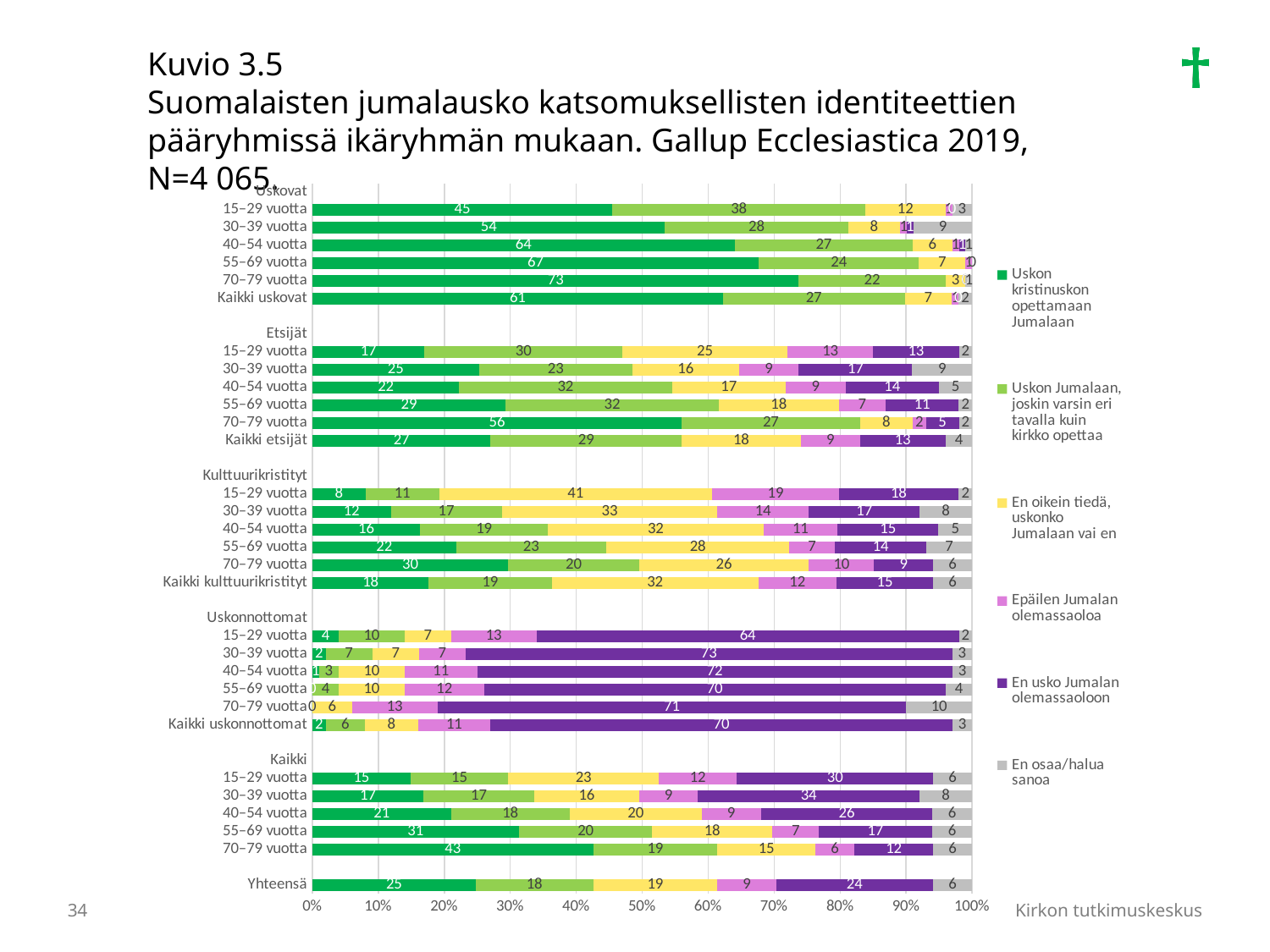
In the Uskonnottomat group, what is the value for 'En usko Jumalan olemassaoloon' for 15–29 vuotta? 64 Among the Kulttuurikristityt age groups, which has the lowest value for 'Uskon kristinuskon opettamaan Jumalaan'? 15–29 vuotta In the Uskovat group, what is the value for 'Uskon kristinuskon opettamaan Jumalaan' for 70–79 vuotta? 73 In the Kaikki uskonnottomat bar, what is the value for 'En usko Jumalan olemassaoloon'? 70 What kind of chart is shown on the slide? Stacked bar chart In the Yhteensä bar, what is the value for 'Uskon kristinuskon opettamaan Jumalaan'? 25 In the Kaikki etsijät bar, what is the difference between 'Uskon Jumalaan, joskin varsin eri tavalla kuin kirkko opettaa' (29) and 'Uskon kristinuskon opettamaan Jumalaan' (27)? 2 How many series does the legend list? 6 In the Kaikki kulttuurikristityt bar, which is larger: 'En oikein tiedä, uskonko Jumalaan vai en' or 'Uskon kristinuskon opettamaan Jumalaan'? En oikein tiedä, uskonko Jumalaan vai en In the Kaikki group, does the value for 'Uskon kristinuskon opettamaan Jumalaan' rise or fall as the age group gets older from 15–29 vuotta to 70–79 vuotta? rise Among the Uskovat age groups, which has the highest value for 'Uskon kristinuskon opettamaan Jumalaan'? 70–79 vuotta In the Kaikki group, what is the value for 'Uskon kristinuskon opettamaan Jumalaan' for 70–79 vuotta? 43